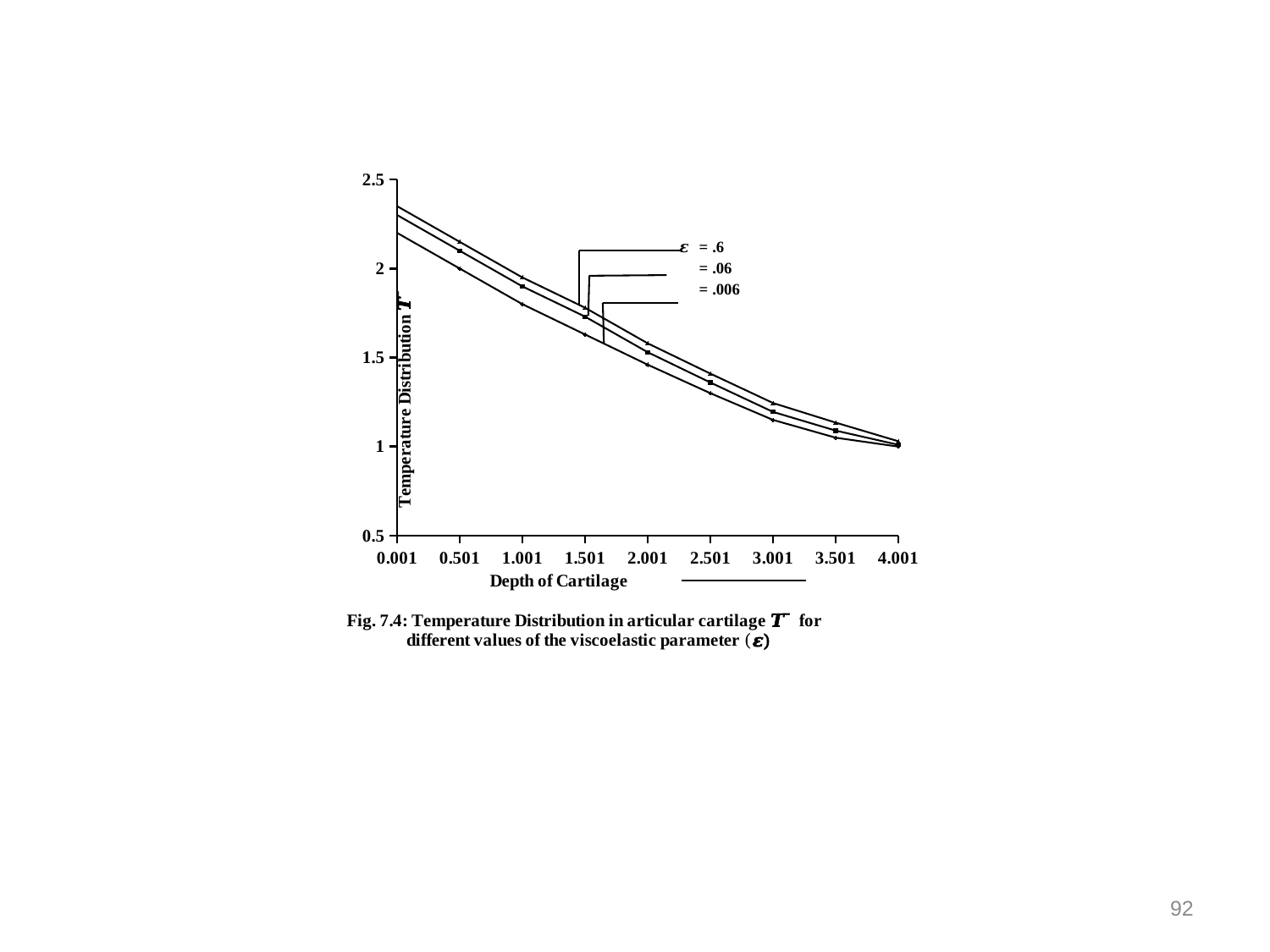
Do the temperature values rise or fall as the depth of cartilage increases? fall At a depth of 0.001, is the temperature for ε = .6 greater or less than 2? greater What kind of chart is shown on the slide? line chart Which series has the highest temperature at a depth of 0.001? ε = .6 What is the figure number given in the caption below the chart? Fig. 7.4 Which series has the lowest temperature at a depth of 1.001? ε = .006 How many series (values of ε) are plotted on the chart? 3 What is the label of the x axis of the chart? Depth of Cartilage At a depth of 3.001, is the temperature for ε = .006 greater or less than 1.5? less At a depth of 2.001, which is larger: the temperature for ε = .6 or for ε = .006? ε = .6 At a depth of 1.001, is the temperature for ε = .006 greater or less than 2? less How many depth values are marked along the x axis of the chart? 9